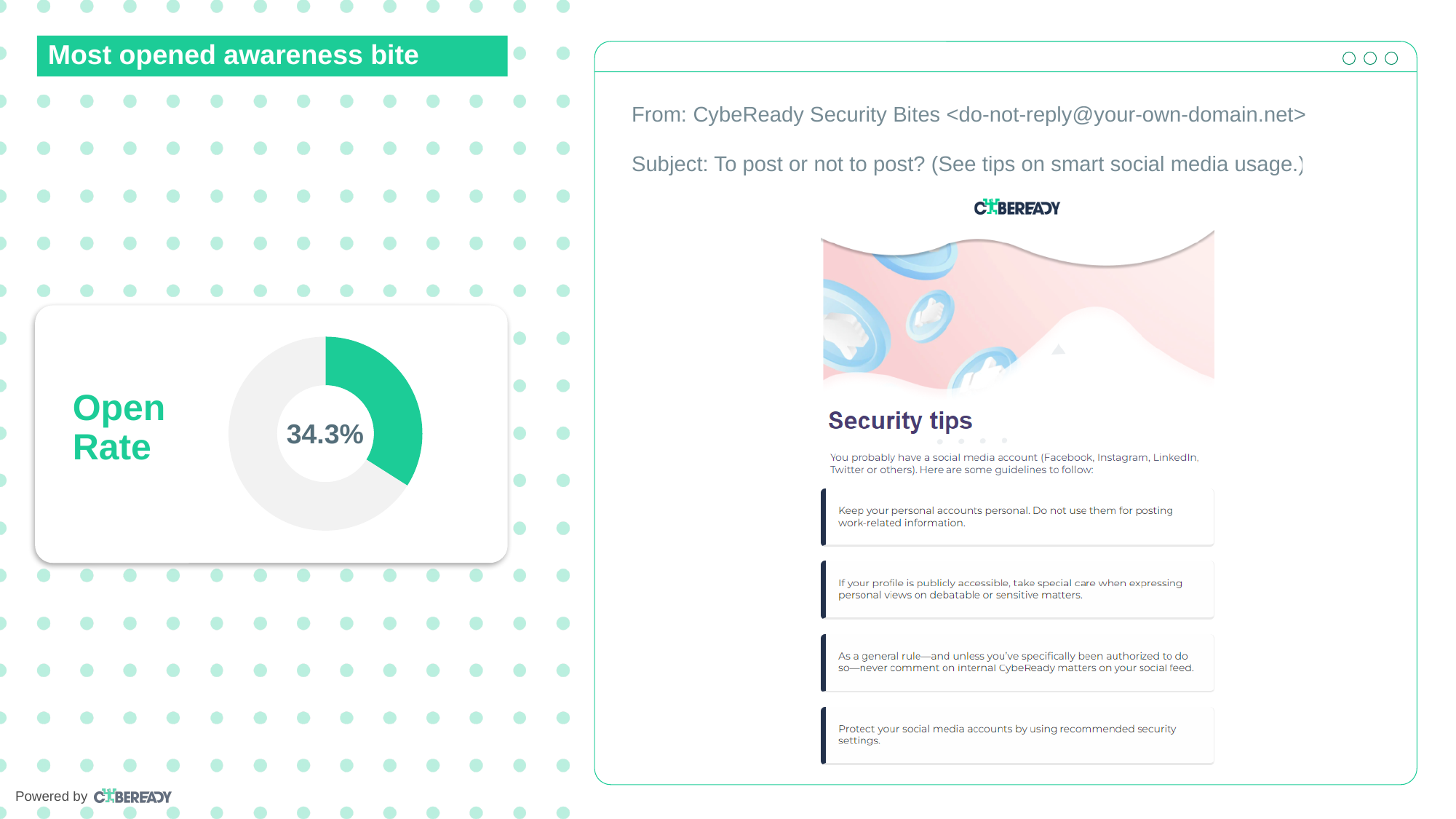
What share of the donut chart does the green segment represent? 34.3% What kind of chart is used to show the open rate? Donut (pie) chart Is the open rate shown in the donut chart greater or less than 50%? less What colour is the filled (opened) portion of the donut chart? Green What metric label appears next to the donut chart? Open Rate How many segments does the donut chart have? 2 In the donut chart, which segment is larger: the green (opened) segment or the grey (remainder) segment? The grey segment What open rate does the donut chart show? 34.3%